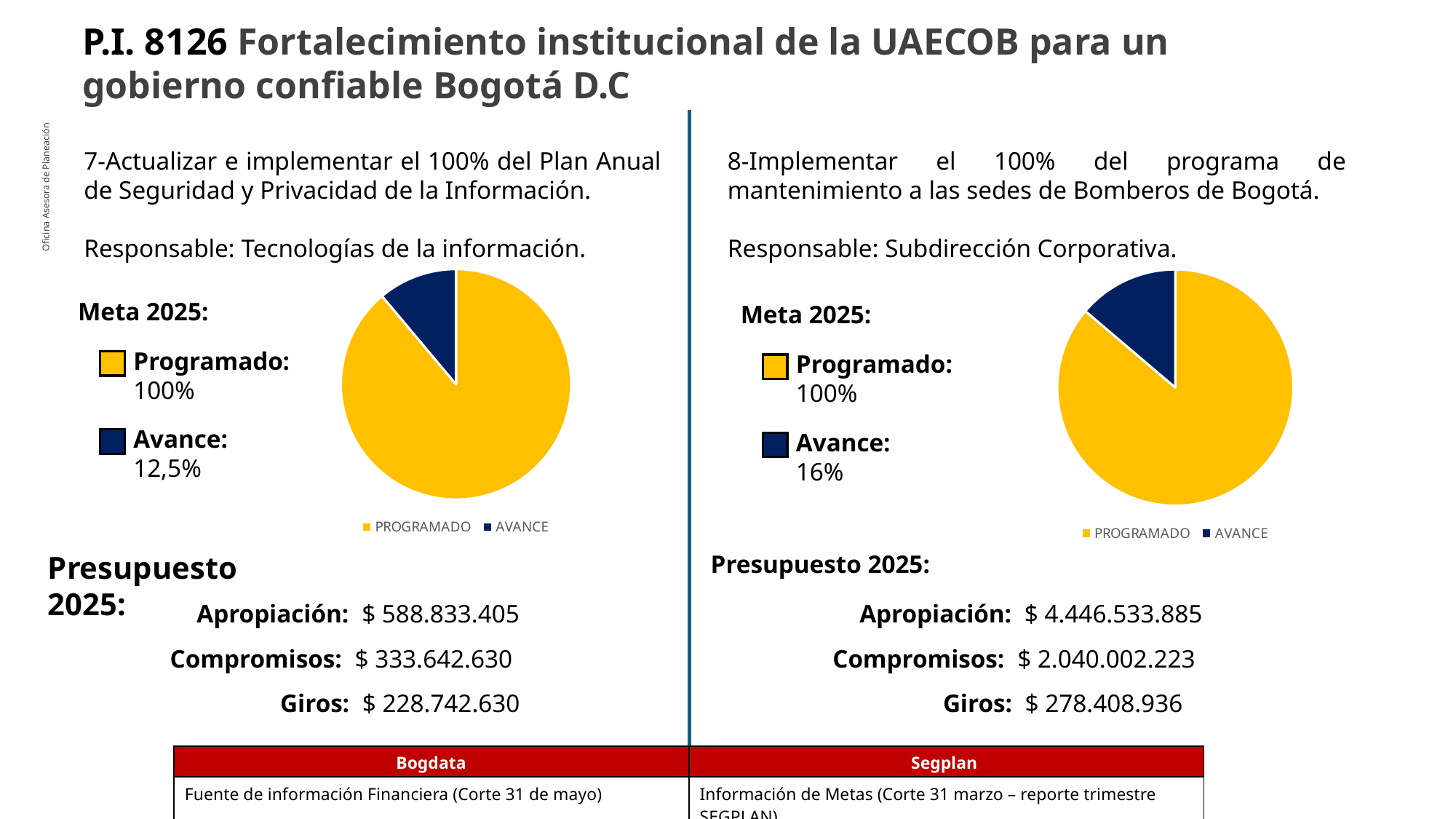
In the right pie chart, what colour is the AVANCE slice? dark blue In the left pie chart (meta 7), what is the Avance value? 12,5% How many entries does the legend of the left pie chart list? 2 What type of chart is shown on the left side of the slide? pie chart What type of chart is shown on the right side of the slide? pie chart In the right pie chart (meta 8), which slice is the smallest? AVANCE In the left pie chart (meta 7), which slice is larger, PROGRAMADO or AVANCE? PROGRAMADO In the right pie chart (meta 8), what is the Avance value? 16% In the right pie chart (meta 8), what is the Programado value? 100% Which Avance value is larger, the one in the left pie chart (meta 7) or the one in the right pie chart (meta 8)? right (meta 8) How many slices does the right pie chart have? 2 In the left pie chart (meta 7), what is the Programado value? 100%